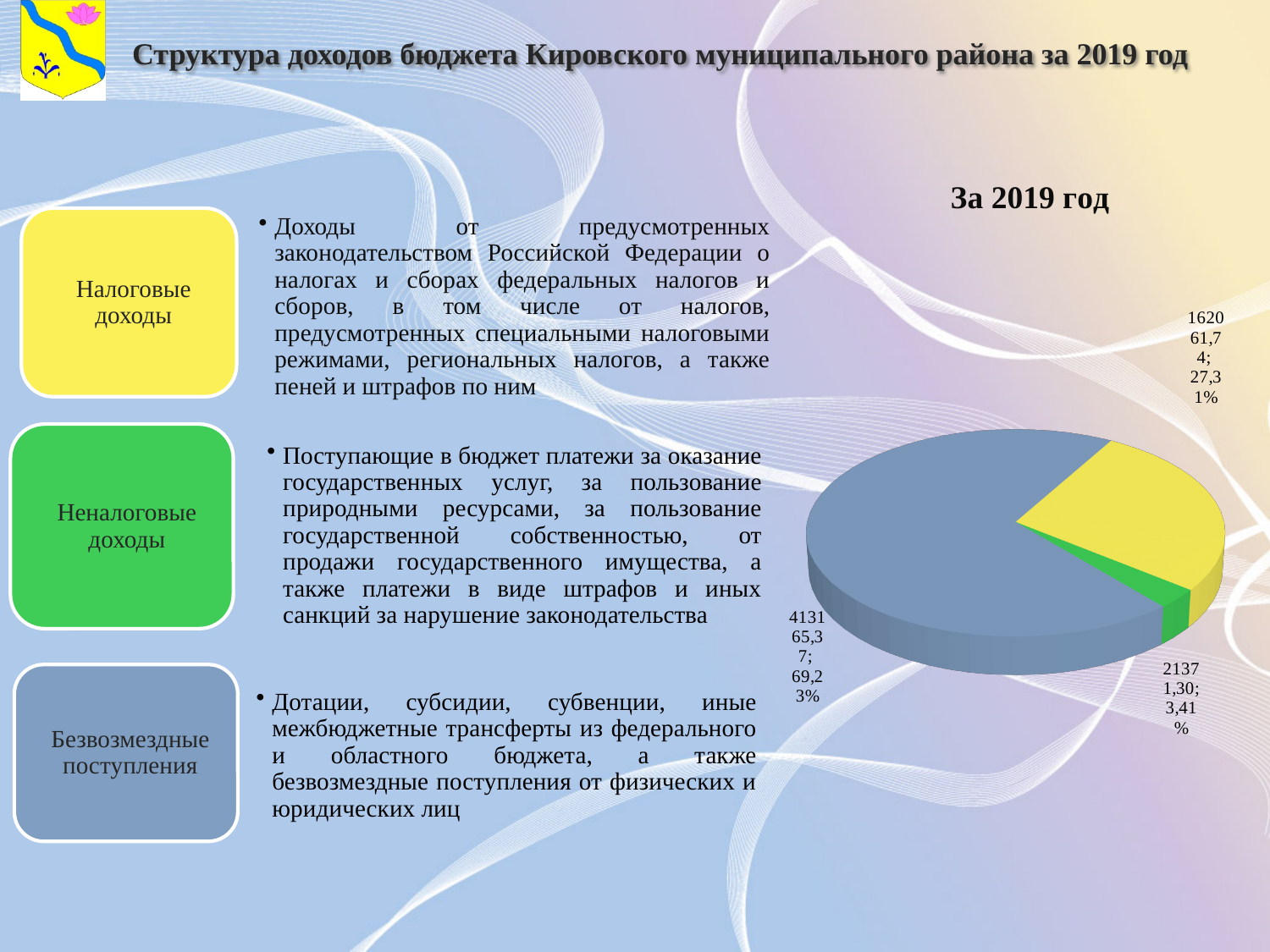
Which slice of the pie chart is the smallest? the green slice (3,41%) What share of the pie does the yellow slice represent? 27,31% What share of the pie does the green slice represent? 3,41% What is the title of the chart on the slide? За 2019 год What value is labelled on the yellow slice of the pie chart? 162061,74 What value is labelled on the blue slice of the pie chart? 413165,37 How many slices does the pie chart have? 3 What value is labelled on the green slice of the pie chart? 21371,30 Which slice of the pie chart is the largest? the blue slice (69,23%) What kind of chart is shown on the slide? pie chart Which is larger, the yellow slice or the green slice? the yellow slice What share of the pie does the blue slice represent? 69,23%